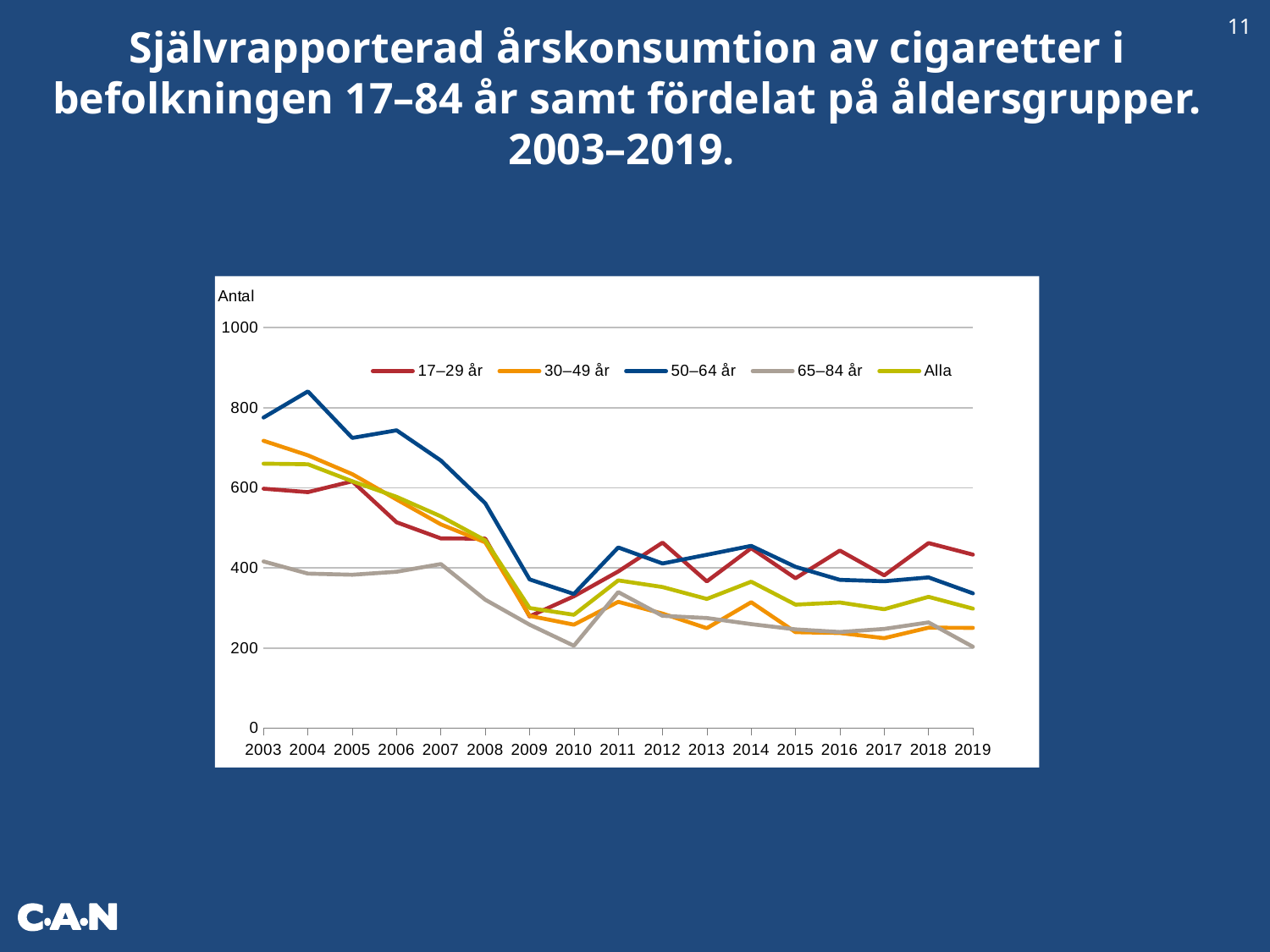
Which series has the lowest value in 2003? 65–84 år Which series has the highest value in 2003? 50–64 år Is the value for 30–49 år in 2003 greater or less than 600? greater Which series has the highest value in 2019? 17–29 år How many series does the legend list? 5 What kind of chart is shown on the slide? line chart Does the value for 50–64 år rise or fall overall from 2003 to 2019? fall Is the value for 50–64 år in 2004 greater or less than 800? greater Is the value for 50–64 år in 2019 greater or less than 400? less In 2004, which is larger: the value for 50–64 år or the value for 17–29 år? 50–64 år How many years are shown along the x axis? 17 What label is shown on the vertical axis? Antal